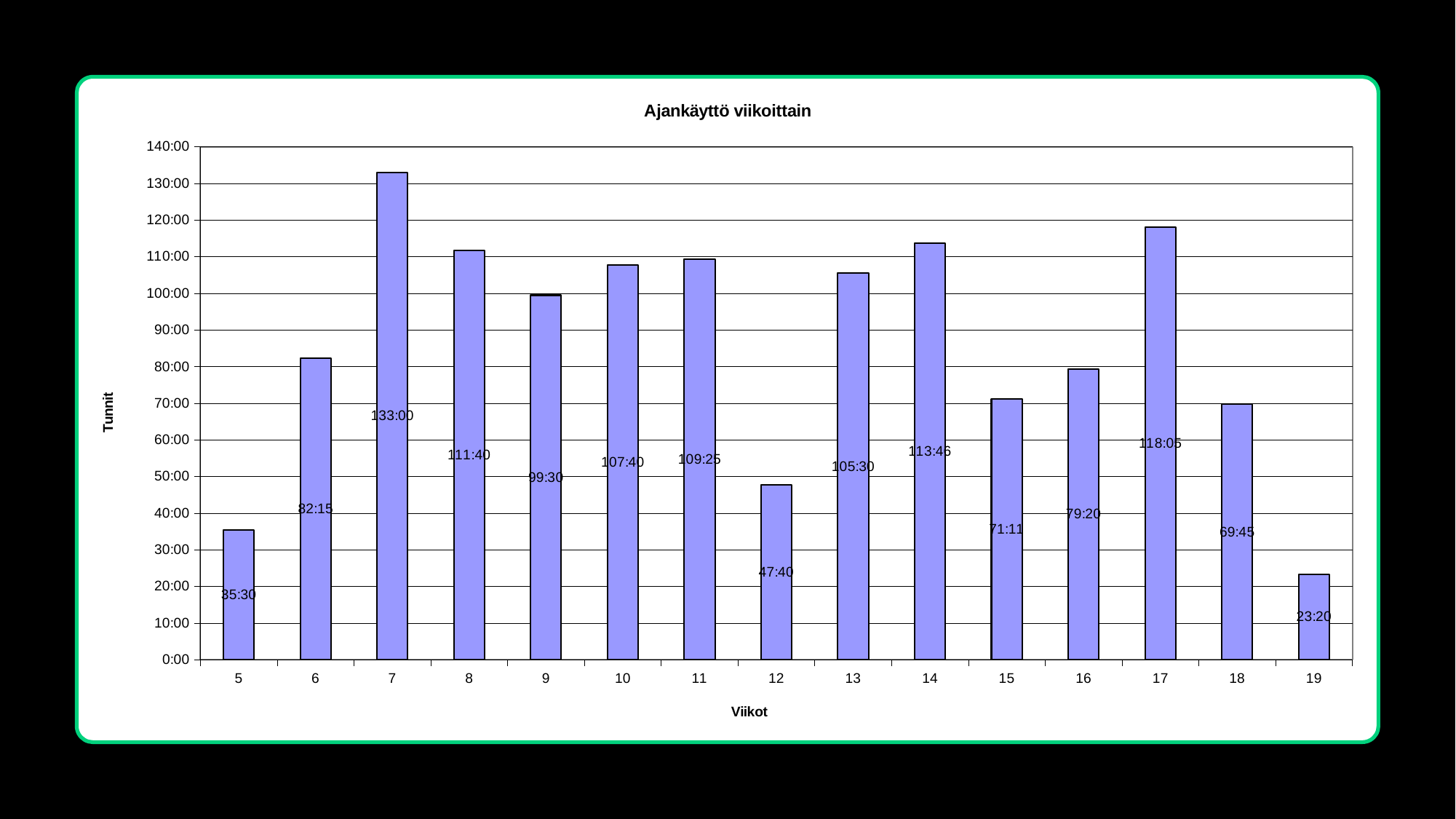
What kind of chart is shown on the slide? bar chart What is the value for week 7? 133:00 What is the label of the y axis? Tunnit How many weeks (bars) are plotted in the chart? 15 Which week has the highest value? 7 What is the title of the chart? Ajankäyttö viikoittain Which week has the lowest value? 19 Is the value for week 12 greater or less than 50:00? less What is the value for week 14? 113:46 Which is larger, the value for week 10 or the value for week 11? week 11 What is the difference between the values for week 8 and week 9? 12:10 What is the value for week 19? 23:20